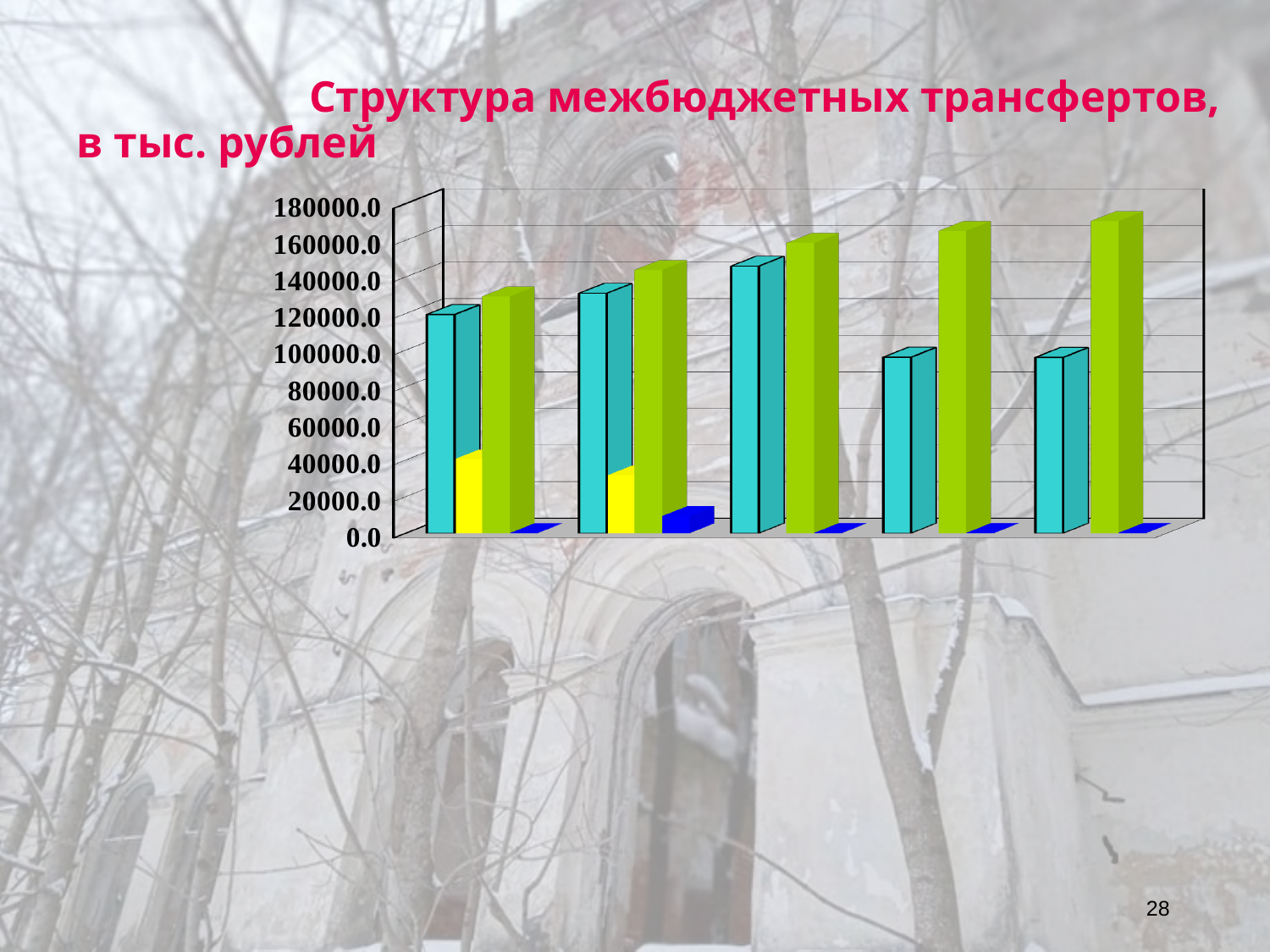
Is the value of the cyan bar in the fourth group from the left greater or less than 120000.0? less What kind of chart is shown on the slide? bar chart Is the value of the green bar in the rightmost group greater or less than 160000.0? greater What is the title of the chart on the slide? Структура межбюджетных трансфертов, в тыс. рублей In the rightmost group, which is larger: the cyan bar or the green bar? the green bar How many groups of bars are plotted along the x axis? 5 What is the highest value shown on the vertical axis? 180000.0 Do the green bars rise or fall from left to right across the groups? rise Is the value of the green bar in the leftmost group greater or less than 120000.0? greater Which group of bars has the tallest green bar? the rightmost group Which group of bars has the tallest cyan bar? the third group from the left